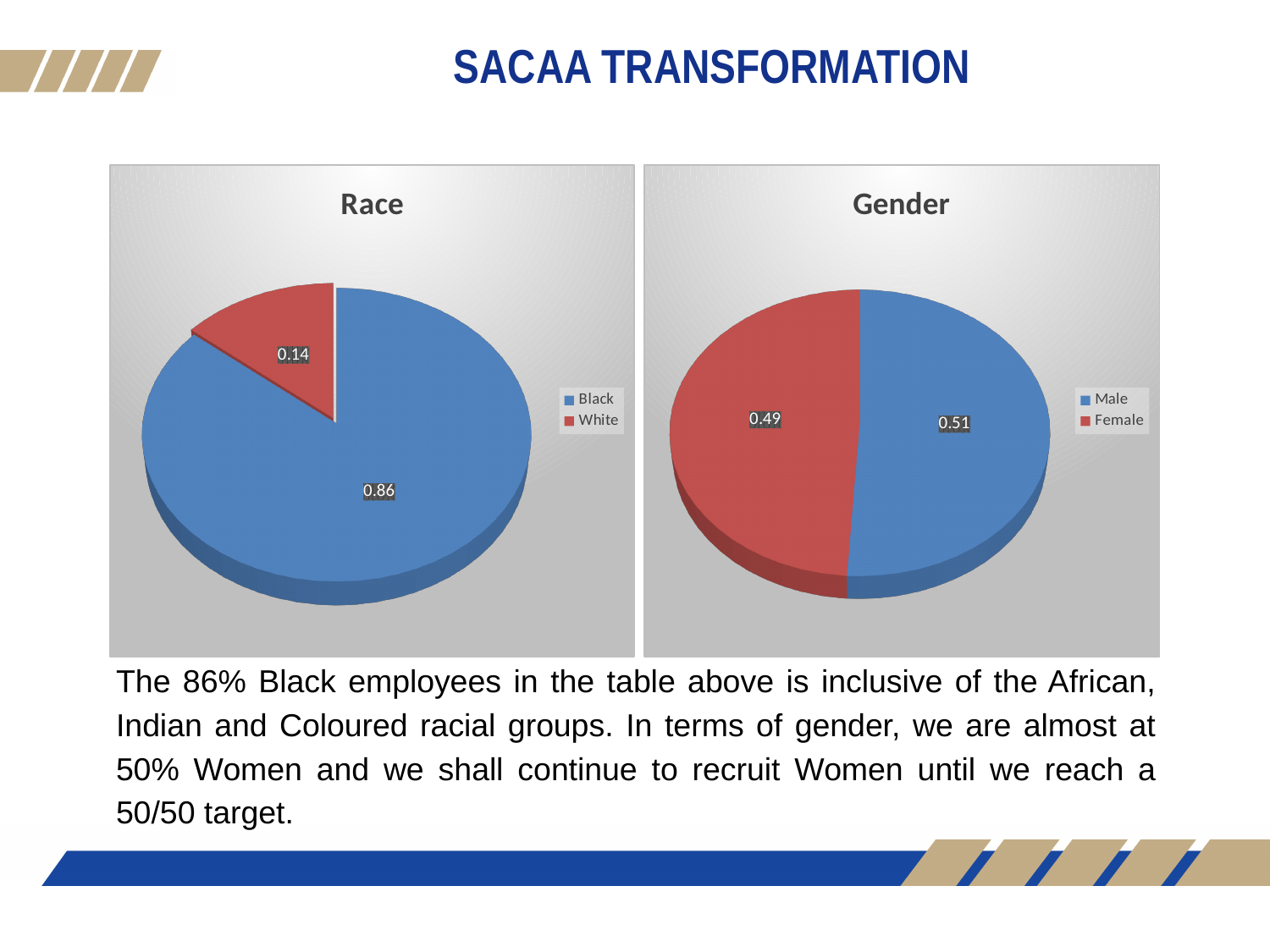
In the Gender chart, what colour is the Female slice? Red In the Gender chart, which is larger, Male or Female? Male In the Race chart, what value is shown for Black? 0.86 In the Race chart, which category has the smallest slice? White In the Gender chart, what is the difference between the Male and Female values? 0.02 In the Race chart, what is the difference between the Black and White values? 0.72 How many categories does the Race chart show? 2 In the Gender chart, what value is shown for Female? 0.49 In the Race chart, which category has the largest slice? Black What kind of chart is the Gender chart? Pie chart In the Race chart, what value is shown for White? 0.14 In the Gender chart, what value is shown for Male? 0.51